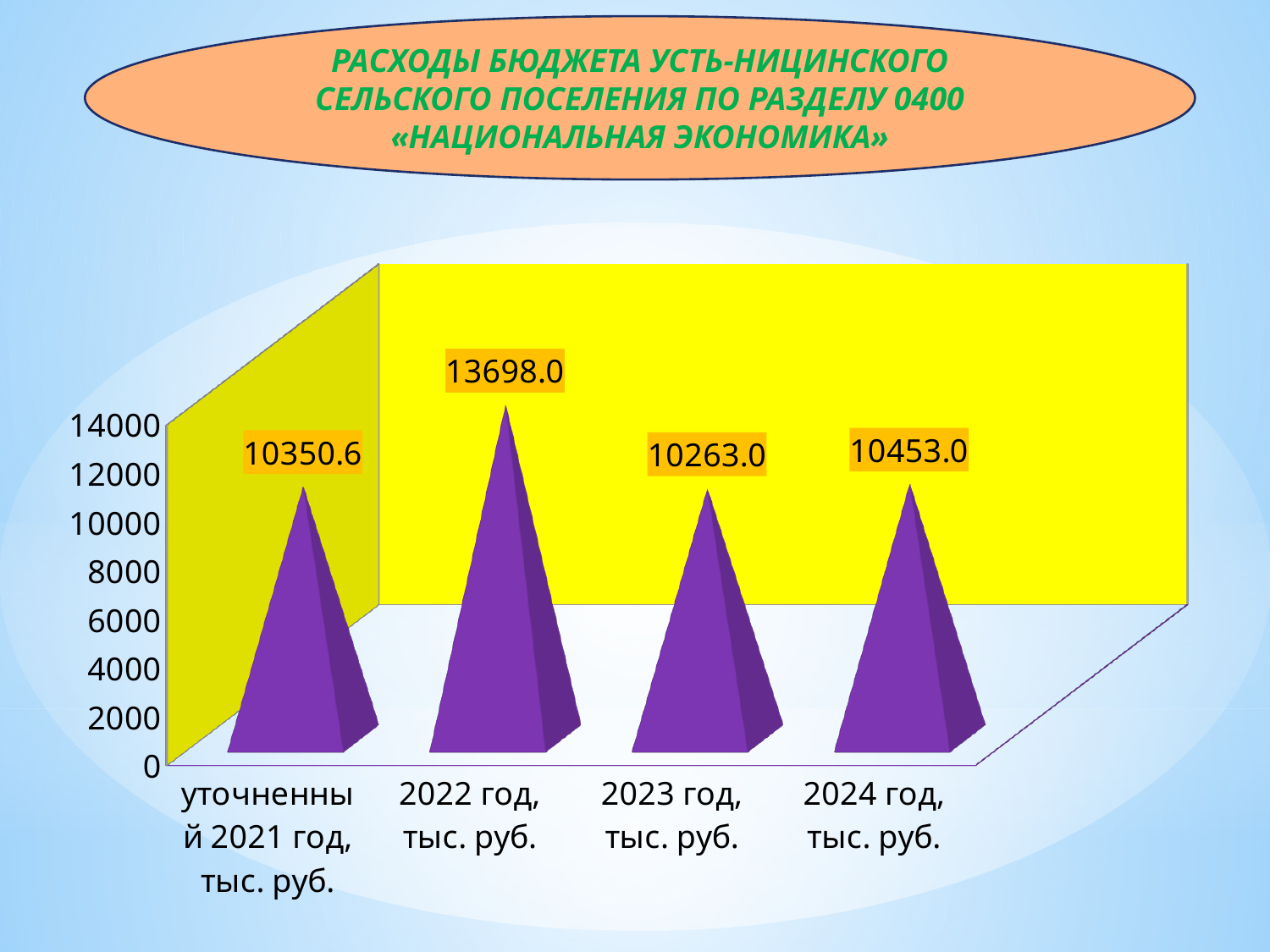
What is the difference between the values for 2022 год and уточненный 2021 год? 3347.4 What is the value for 2022 год, тыс. руб.? 13698.0 What is the value for уточненный 2021 год, тыс. руб.? 10350.6 Which category has the highest value? 2022 год, тыс. руб. What kind of chart is shown on the slide? bar chart What is the difference between the values for 2024 год and 2023 год? 190.0 How many categories are shown on the chart? 4 What is the value for 2024 год, тыс. руб.? 10453.0 What is the value for 2023 год, тыс. руб.? 10263.0 Which category has the lowest value? 2023 год, тыс. руб. Which is larger, the value for 2024 год or the value for 2023 год? 2024 год, тыс. руб. Is the value for 2022 год greater or less than 12000? greater